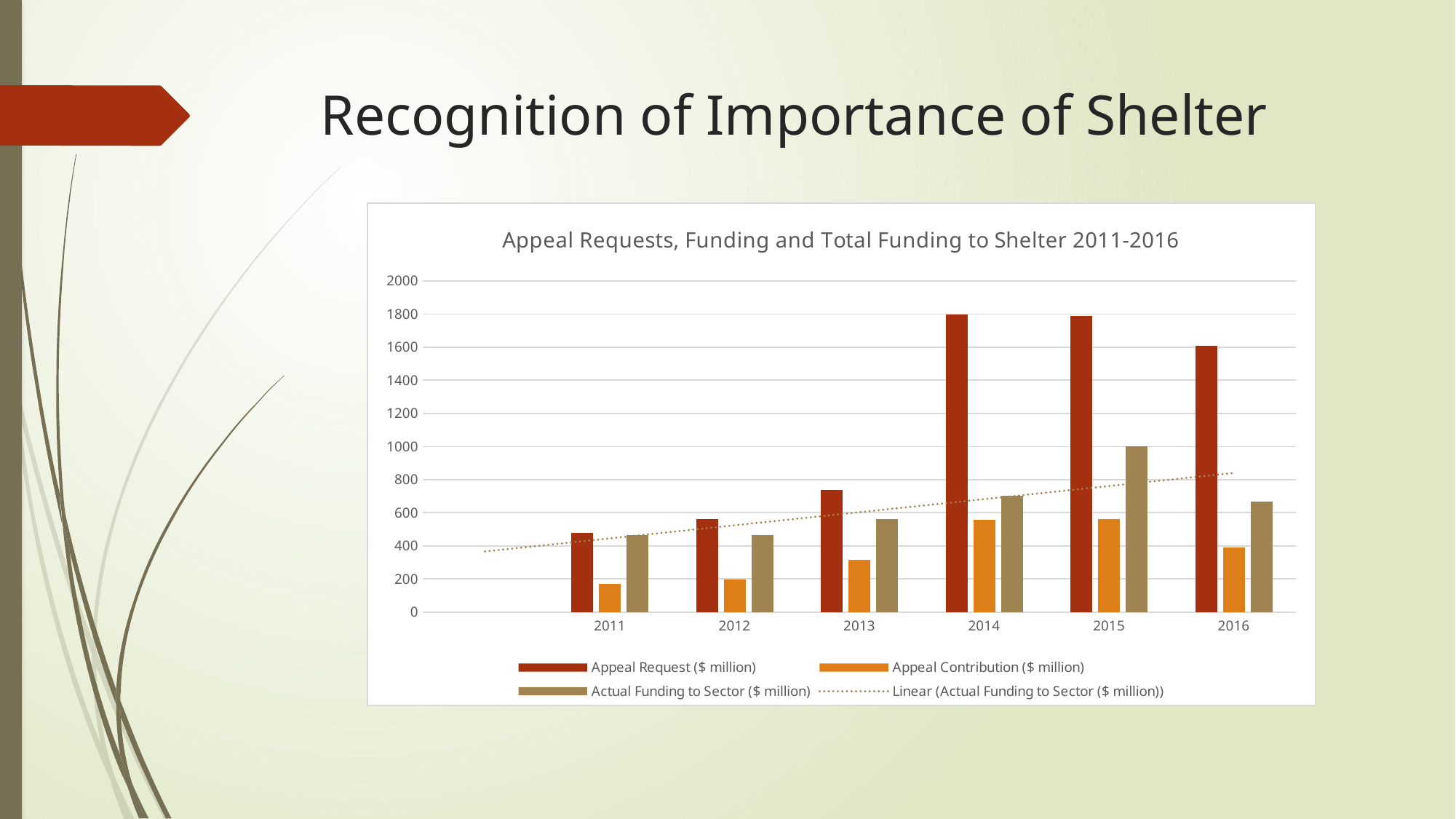
In 2014, which is larger: Appeal Request ($ million) or Actual Funding to Sector ($ million)? Appeal Request ($ million) What is the title of the chart? Appeal Requests, Funding and Total Funding to Shelter 2011-2016 How many entries does the chart's legend list? 4 Is the Appeal Request ($ million) value for 2013 greater or less than 600? greater How many years are shown on the x axis of the chart? 6 Is the Actual Funding to Sector ($ million) value for 2015 greater or less than 800? greater What type of chart is shown on the slide? bar chart Is the Appeal Contribution ($ million) value for 2011 greater or less than 200? less Does the dotted linear trendline for Actual Funding to Sector rise or fall from 2011 to 2016? rise Which year has the highest Actual Funding to Sector ($ million) value? 2015 Which year has the lowest Appeal Request ($ million) value? 2011